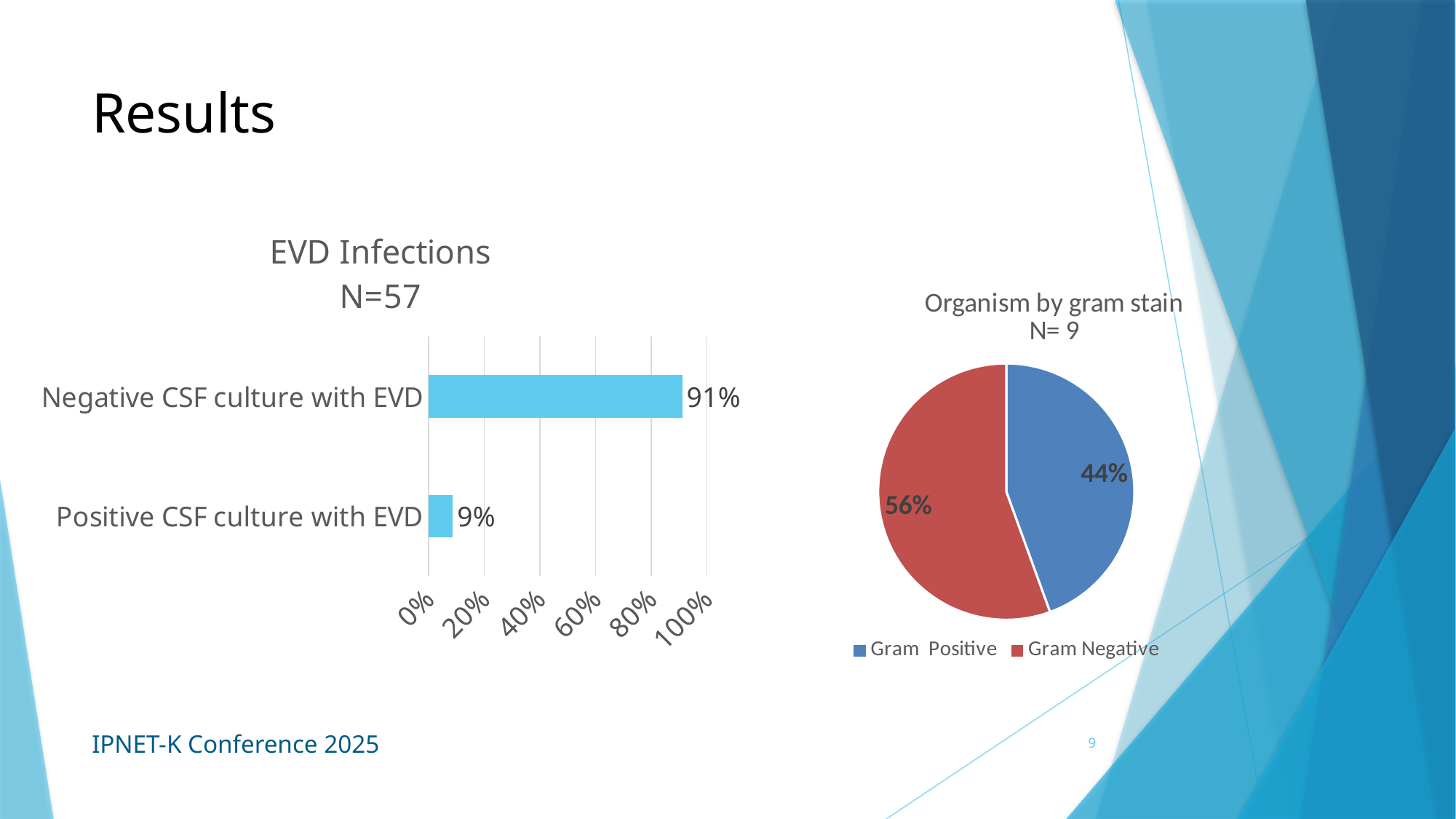
In the 'EVD Infections N=57' chart, what is the difference between the Negative and Positive CSF culture values? 82% What kind of chart is the 'Organism by gram stain N= 9' chart? pie chart In the 'EVD Infections N=57' chart, how many categories are shown? 2 In the 'EVD Infections N=57' chart, which category has the highest value? Negative CSF culture with EVD In the 'Organism by gram stain N= 9' chart, which slice is larger, Gram Positive or Gram Negative? Gram Negative In the 'Organism by gram stain N= 9' chart, how many entries does the legend list? 2 What kind of chart is the 'EVD Infections N=57' chart? bar chart In the 'EVD Infections N=57' chart, what is the value for Positive CSF culture with EVD? 9% In the 'Organism by gram stain N= 9' chart, what share is Gram Negative? 56% In the 'EVD Infections N=57' chart, is the value for Negative CSF culture with EVD greater or less than 80%? greater In the 'EVD Infections N=57' chart, what is the value for Negative CSF culture with EVD? 91% In the 'Organism by gram stain N= 9' chart, what share is Gram Positive? 44%